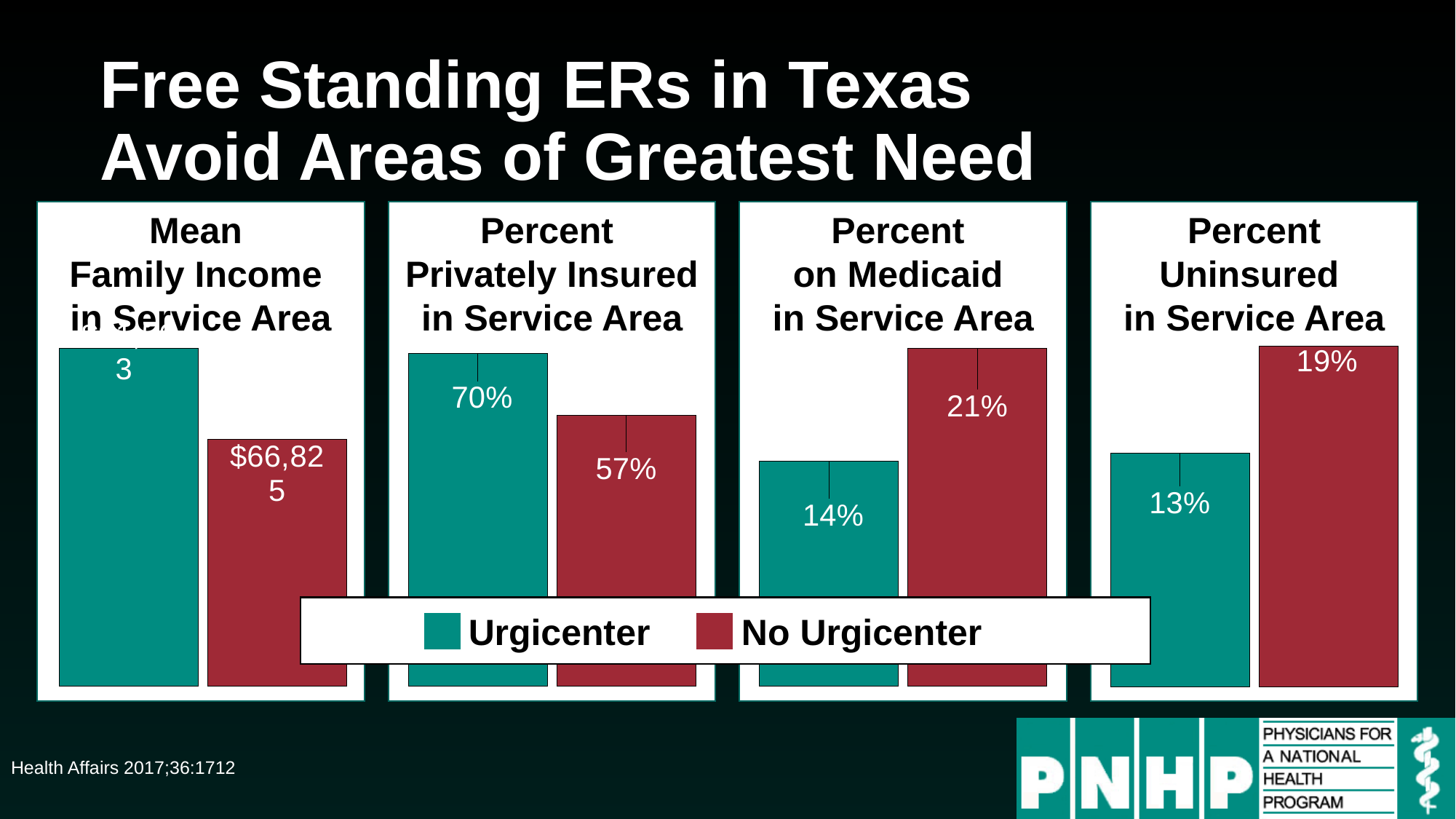
In the Percent Privately Insured in Service Area chart, what is the value for Urgicenter? 70% In the Percent Uninsured in Service Area chart, what is the difference between the No Urgicenter and Urgicenter values? 6% How many series does the legend list for the charts on this slide? 2 In the Mean Family Income in Service Area chart, which bar is taller, Urgicenter or No Urgicenter? Urgicenter In the Percent on Medicaid in Service Area chart, which is larger, Urgicenter or No Urgicenter? No Urgicenter In the Mean Family Income in Service Area chart, what is the value for No Urgicenter? $66,825 In the Percent Uninsured in Service Area chart, what is the value for No Urgicenter? 19% In the Percent on Medicaid in Service Area chart, what is the value for Urgicenter? 14% In the Percent Privately Insured in Service Area chart, what is the value for No Urgicenter? 57% In the Percent on Medicaid in Service Area chart, what is the value for No Urgicenter? 21% In the Percent Privately Insured in Service Area chart, what is the difference between the Urgicenter and No Urgicenter values? 13% What kind of chart is the Percent Uninsured in Service Area chart? Bar chart